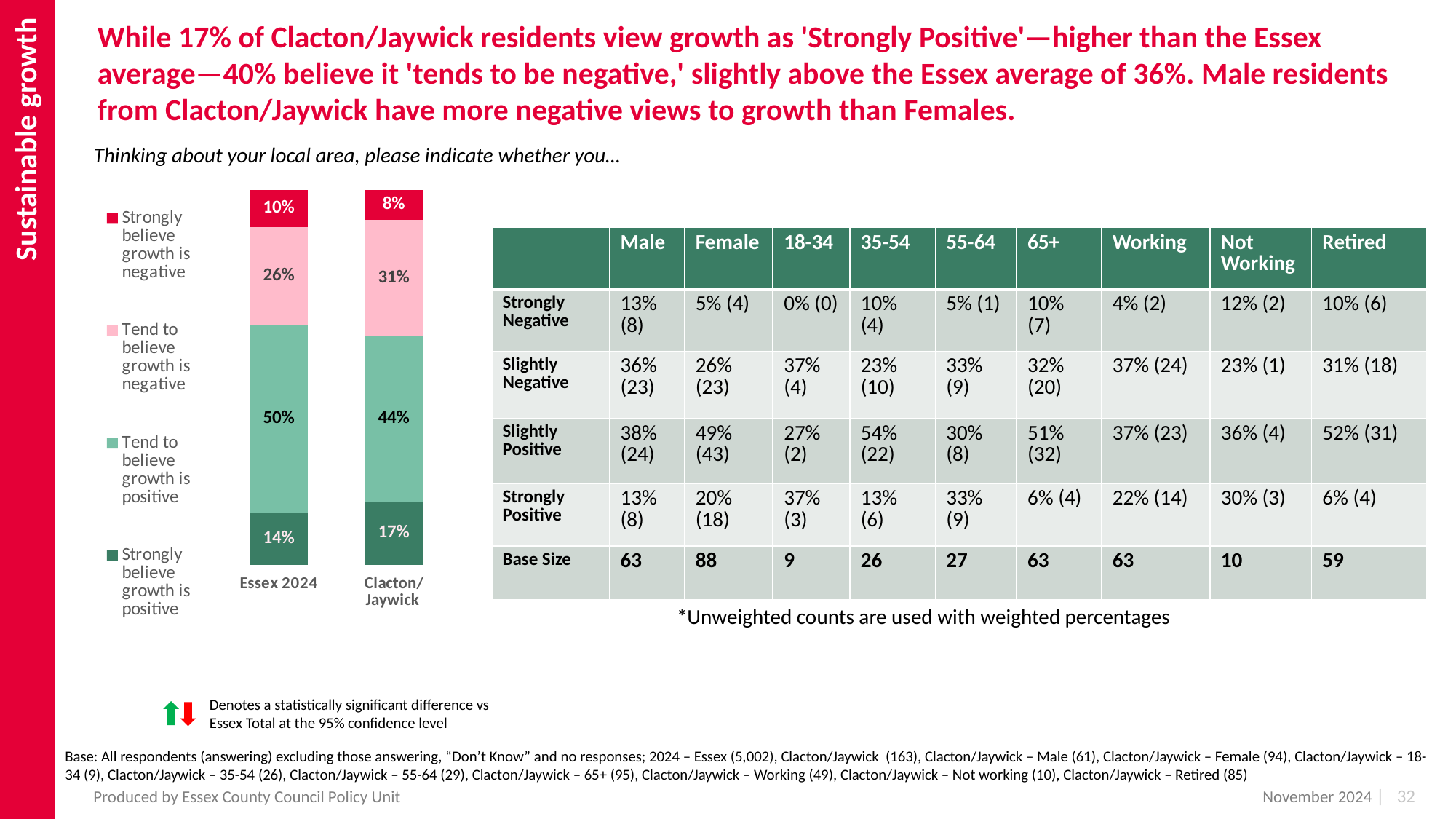
What type of chart is shown on the slide? Stacked bar chart What percentage of Clacton/Jaywick respondents 'Strongly believe growth is positive'? 17% What percentage of Essex 2024 respondents 'Tend to believe growth is positive'? 50% What is the combined percentage of Clacton/Jaywick respondents who 'Strongly believe' or 'Tend to believe' growth is negative? 39% What is the difference between the 'Tend to believe growth is positive' values for Essex 2024 and Clacton/Jaywick? 6 percentage points Which has a higher 'Strongly believe growth is positive' value, Essex 2024 or Clacton/Jaywick? Clacton/Jaywick Which segment is the largest in the Clacton/Jaywick bar? Tend to believe growth is positive What percentage of Essex 2024 respondents 'Strongly believe growth is negative'? 10% How many bars are shown in the chart? 2 What percentage of Clacton/Jaywick respondents 'Tend to believe growth is negative'? 31% How many series does the chart legend list? 4 Which segment is the smallest in the Clacton/Jaywick bar? Strongly believe growth is negative